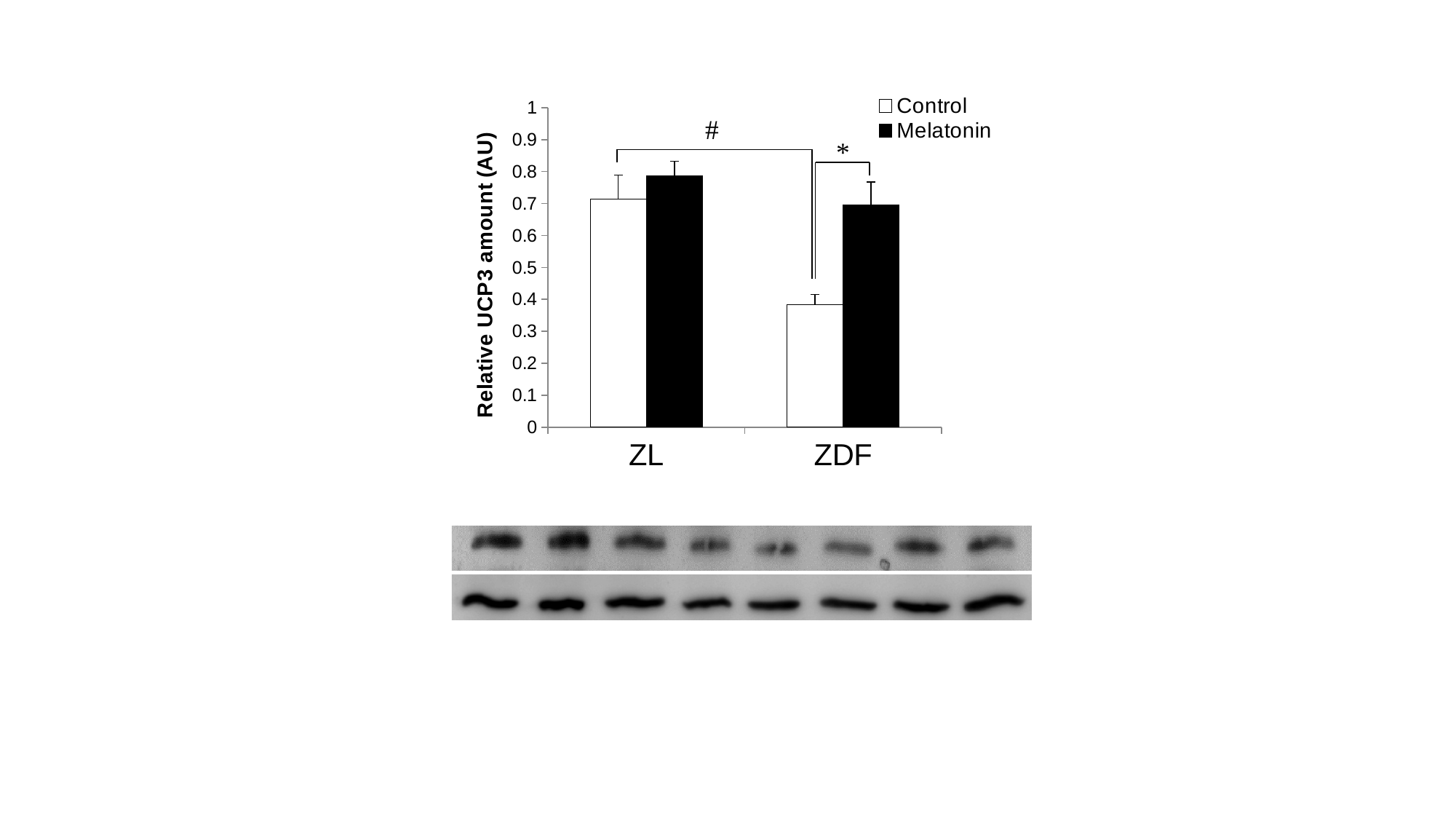
Is the Control value for ZL greater or less than 0.6? greater Which category and series has the lowest bar? ZDF Control What is the label of the y axis? Relative UCP3 amount (AU) How many series does the legend list? 2 How many categories are shown on the x axis? 2 Which series is shown with black bars? Melatonin Which is larger, the Control bar for ZL or the Control bar for ZDF? ZL Is the Control value for ZDF greater or less than 0.5? less For ZDF, which is larger, the Control bar or the Melatonin bar? Melatonin Is the Melatonin value for ZDF greater or less than 0.5? greater What kind of chart is shown on the slide? bar chart Which category and series has the highest bar? ZL Melatonin